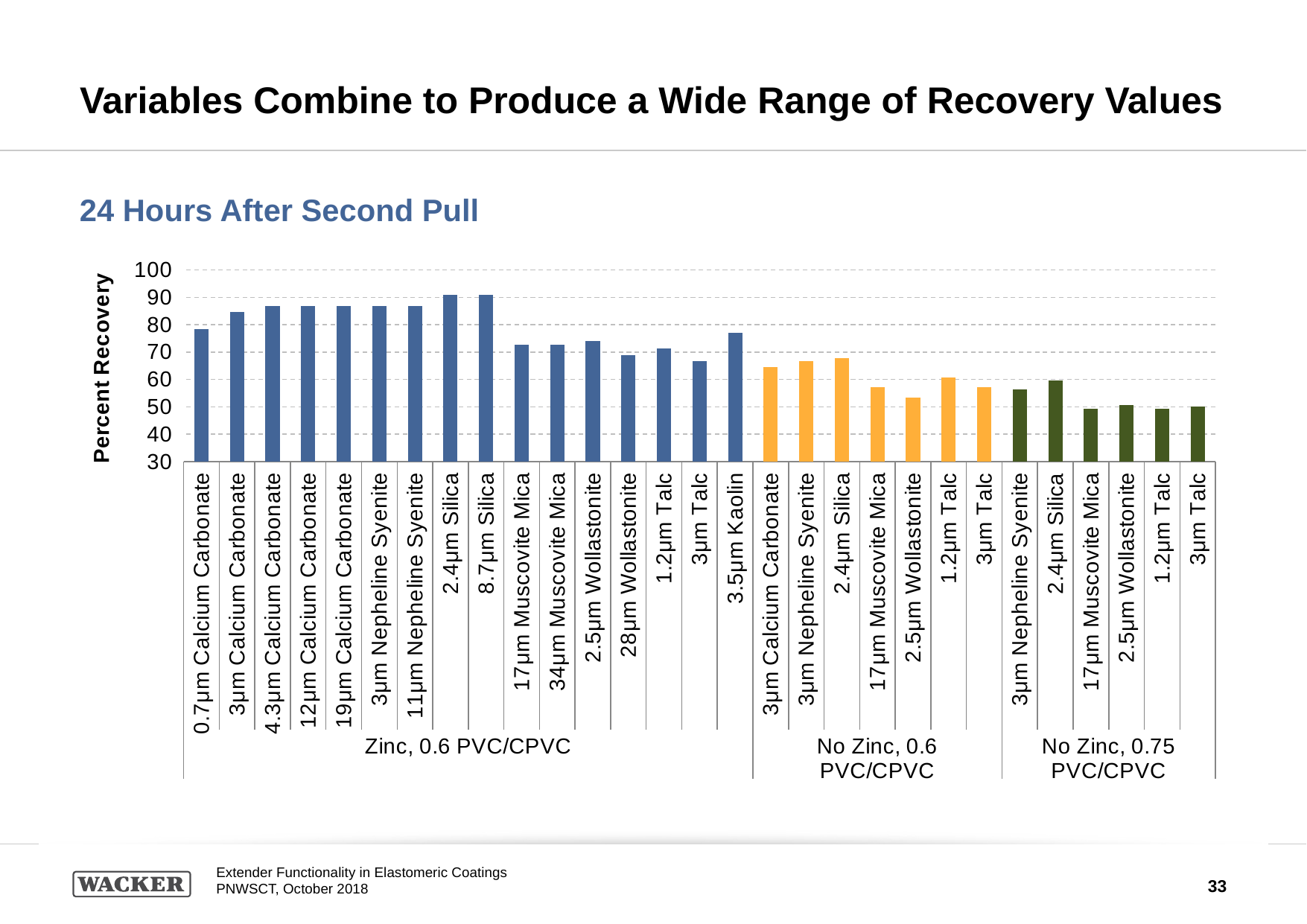
Which has the higher percent recovery: 3µm Calcium Carbonate in the Zinc, 0.6 PVC/CPVC group or 3µm Calcium Carbonate in the No Zinc, 0.6 PVC/CPVC group? Zinc, 0.6 PVC/CPVC Is the value for 3µm Nepheline Syenite in the No Zinc, 0.75 PVC/CPVC group greater or less than 60? less How many bars are in the 'Zinc, 0.6 PVC/CPVC' group? 16 What is the label on the vertical axis of the chart? Percent Recovery How many bars are plotted in the chart in total? 29 How many bars are in the 'No Zinc, 0.75 PVC/CPVC' group? 6 What kind of chart is shown on the slide? bar chart Is the value for 2.5µm Wollastonite in the No Zinc, 0.6 PVC/CPVC group greater or less than 60? less Which has the higher percent recovery: 2.4µm Silica in the Zinc, 0.6 PVC/CPVC group or 2.4µm Silica in the No Zinc, 0.6 PVC/CPVC group? Zinc, 0.6 PVC/CPVC Is the value for 3.5µm Kaolin in the Zinc, 0.6 PVC/CPVC group greater or less than 70? greater